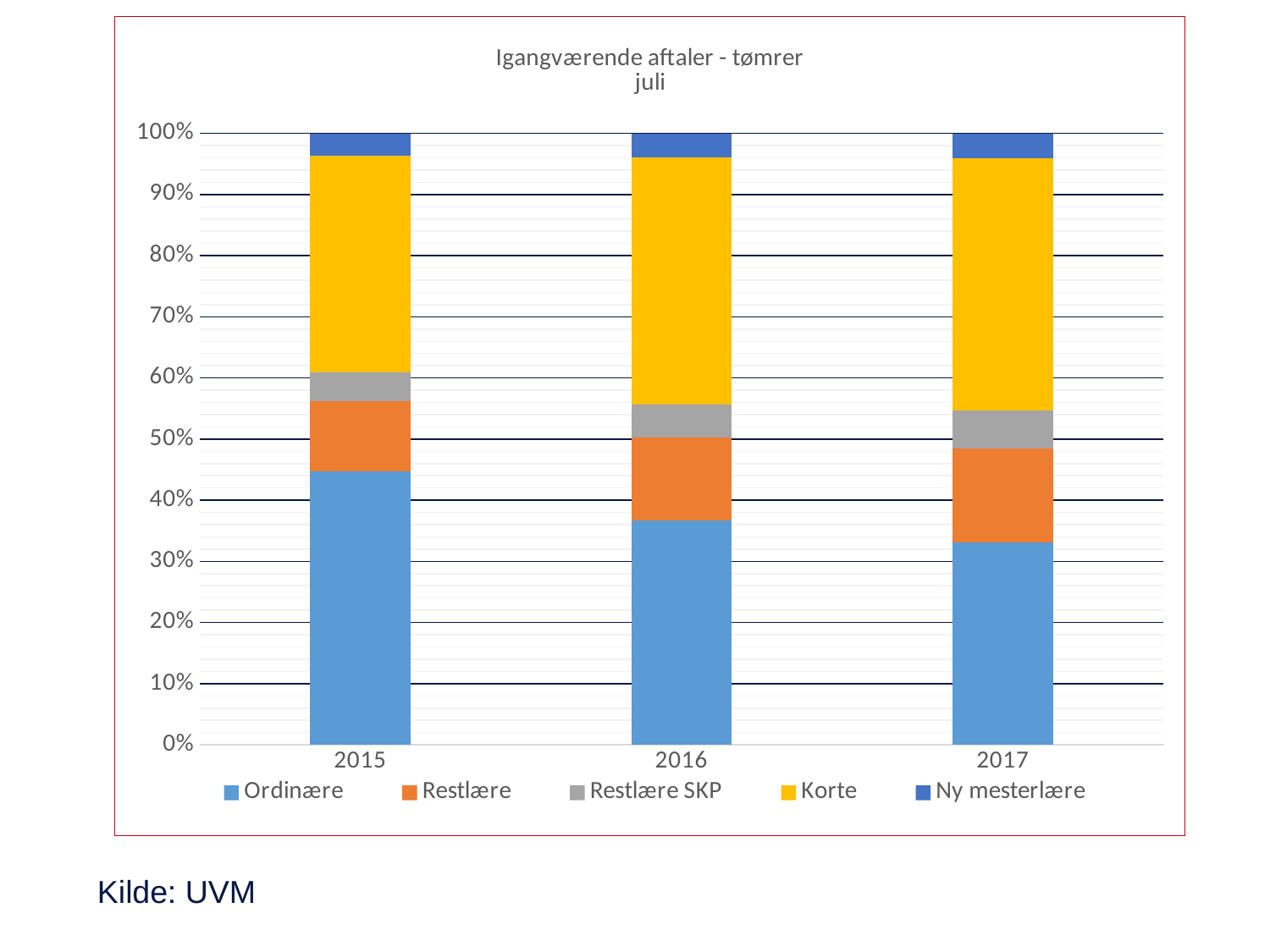
How many series does the legend list? 5 Which colour represents the series Korte in the chart? Yellow What does each stacked bar total on the y axis? 100% Is the share of Ordinære in 2015 greater or less than 40%? greater Which year has the largest share of Ordinære? 2015 Which year has the larger share of Korte, 2015 or 2017? 2017 What kind of chart is shown on the slide? Stacked bar chart How many years are shown on the x axis of the chart? 3 What is the title of the chart? Igangværende aftaler - tømrer juli Does the share of Ordinære rise or fall from 2015 to 2017? Fall Is the share of Ordinære in 2017 greater or less than 40%? less Which year has the smallest share of Ordinære? 2017